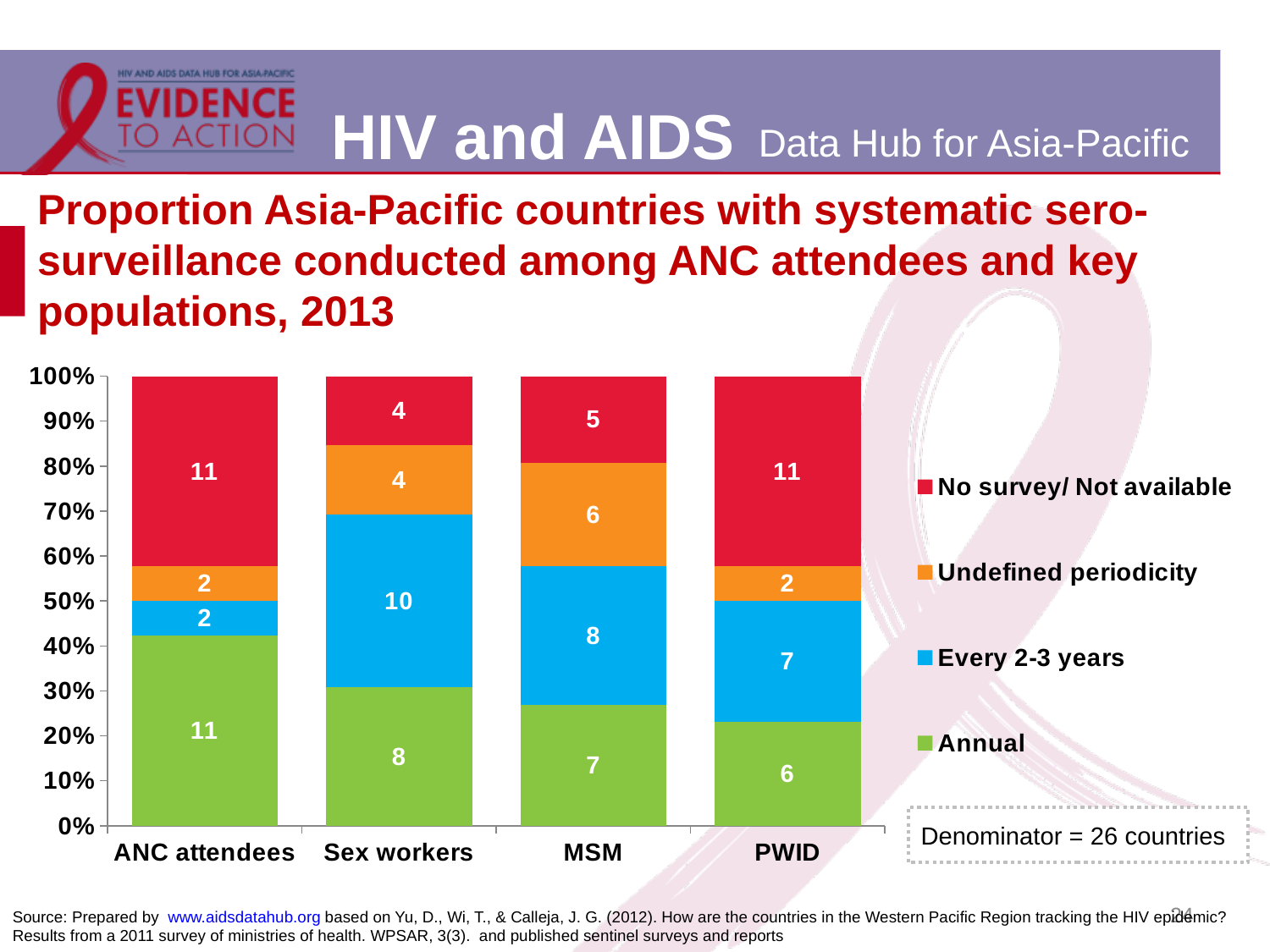
Which category has the highest Annual value? ANC attendees How many series does the legend list? 4 What kind of chart is shown on the slide? Stacked bar chart What is the Every 2-3 years value for Sex workers? 10 How many categories are shown on the x axis? 4 Which is larger, the Annual value for Sex workers or the Annual value for PWID? Sex workers What is the difference between the No survey/ Not available values for ANC attendees and MSM? 6 Which category has the lowest Every 2-3 years value? ANC attendees What is the Annual value for ANC attendees? 11 What is the No survey/ Not available value for PWID? 11 What is the Undefined periodicity value for MSM? 6 What is the total of the four segments in the MSM bar? 26